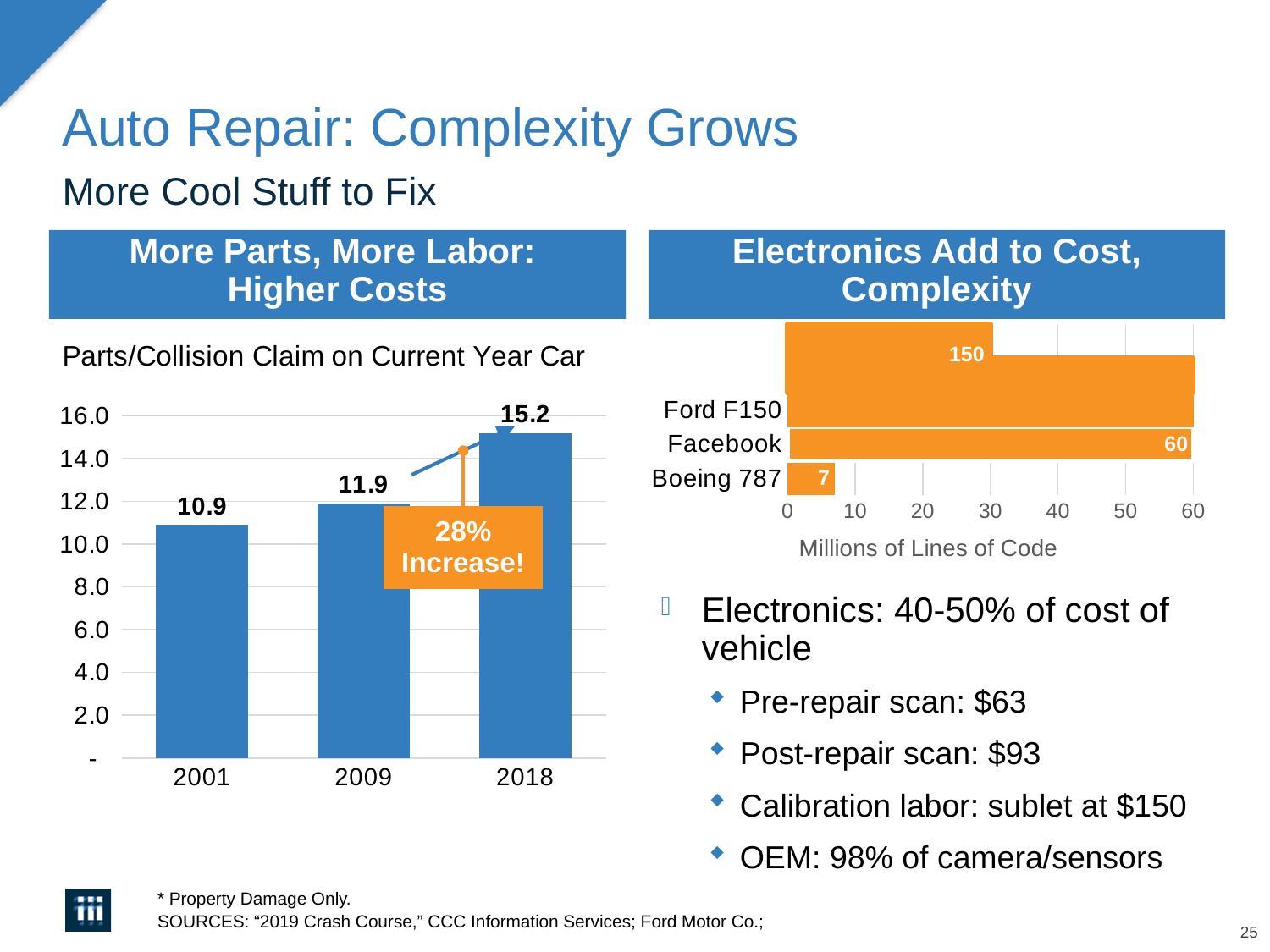
In the right chart (Millions of Lines of Code), what is the value for Ford F150? 150 In the right chart (Millions of Lines of Code), which category has the lowest value? Boeing 787 In the left chart (Parts/Collision Claim on Current Year Car), which year has the lowest value? 2001 In the left chart (Parts/Collision Claim on Current Year Car), what is the difference between the 2018 and 2009 values? 3.3 In the left chart (Parts/Collision Claim on Current Year Car), which year has the highest value? 2018 In the left chart (Parts/Collision Claim on Current Year Car), how many years are shown on the x axis? 3 In the right chart (Millions of Lines of Code), which is larger, Facebook or Boeing 787? Facebook In the right chart (Millions of Lines of Code), what is the value for Boeing 787? 7 In the left chart (Parts/Collision Claim on Current Year Car), what is the value for 2001? 10.9 What kind of chart is the right chart (Millions of Lines of Code)? bar chart In the left chart (Parts/Collision Claim on Current Year Car), do the values rise or fall from 2001 to 2018? rise In the left chart (Parts/Collision Claim on Current Year Car), what is the value for 2018? 15.2